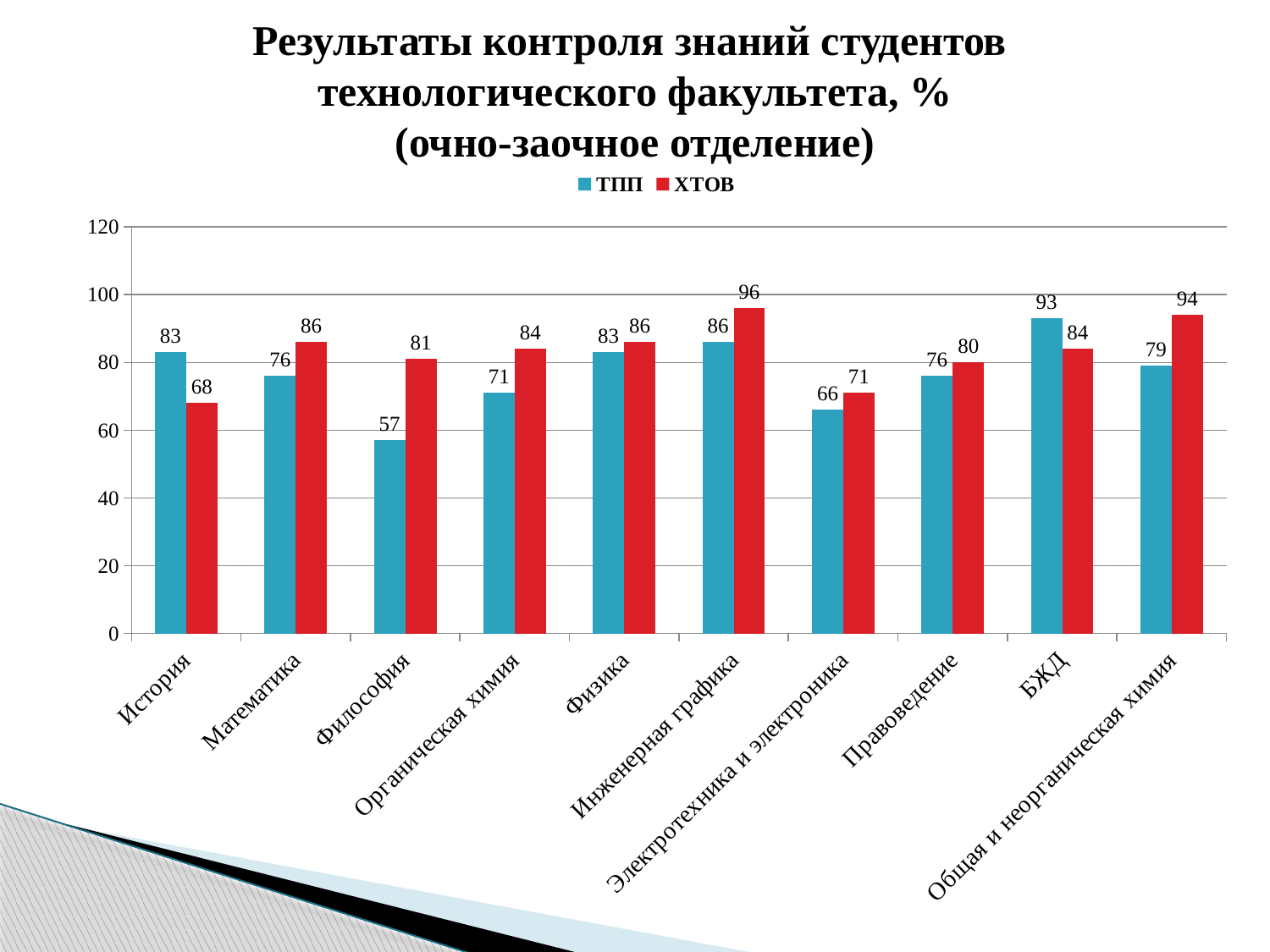
What is the difference between the ХТОВ and ТПП values for Философия? 24 What is the value for ТПП in История? 83 What is the value for ХТОВ in Философия? 81 What kind of chart is shown on the slide? Bar chart Is the ХТОВ value for Общая и неорганическая химия greater or less than 80? greater Which category has the lowest ТПП value? Философия How many categories are shown on the x axis? 10 Which is larger in История: the ТПП value or the ХТОВ value? ТПП What is the value for ТПП in Электротехника и электроника? 66 How many series does the legend list? 2 Which is larger in БЖД: the ТПП value or the ХТОВ value? ТПП Which category has the highest ХТОВ value? Инженерная графика